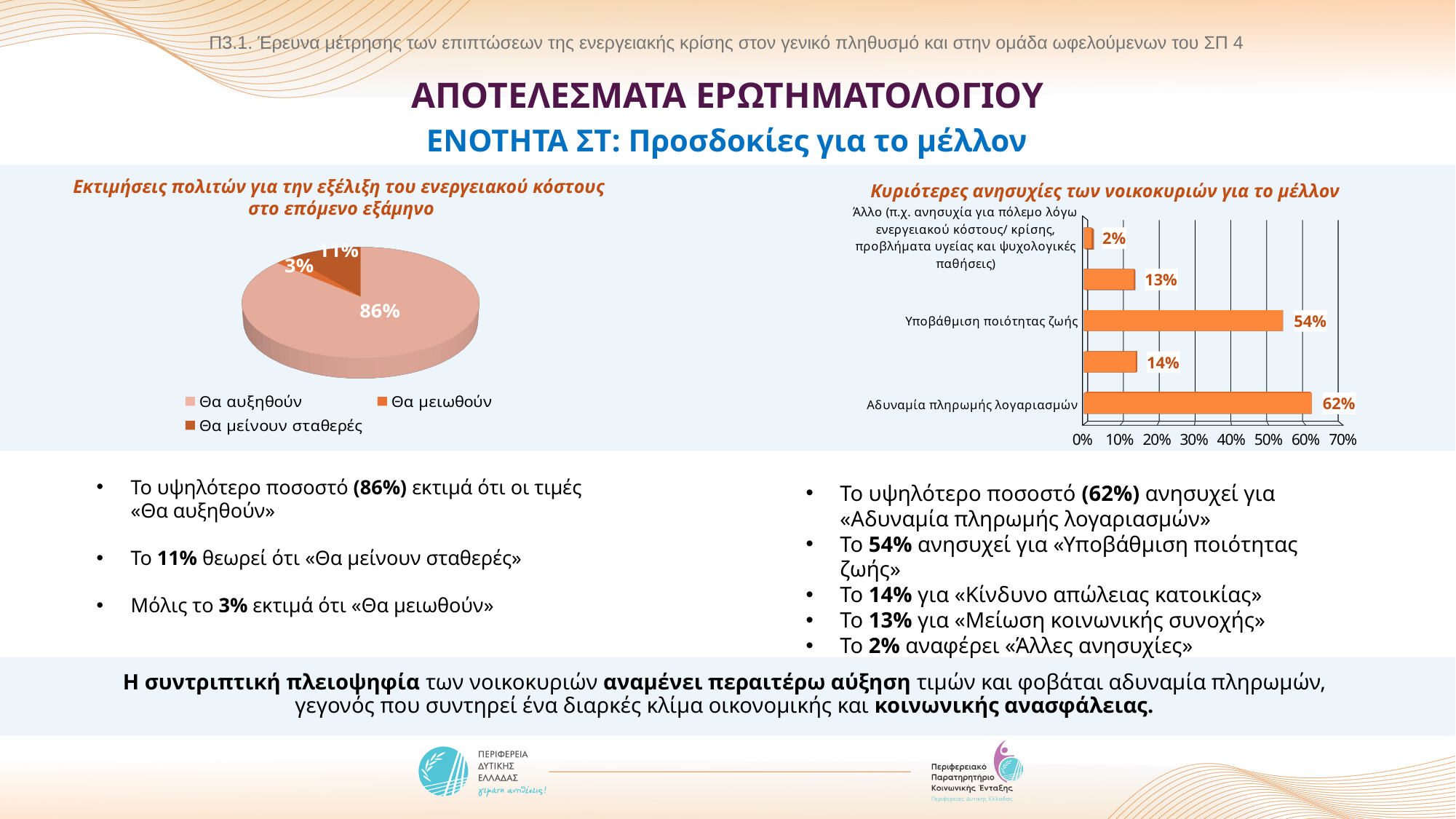
How many bars are plotted in the right bar chart? 5 In the left pie chart, what share is shown for 'Θα μείνουν σταθερές'? 11% In the right bar chart, what is the value for 'Αδυναμία πληρωμής λογαριασμών'? 62% What kind of chart is the left chart titled 'Εκτιμήσεις πολιτών για την εξέλιξη του ενεργειακού κόστους στο επόμενο εξάμηνο'? Pie chart In the right bar chart, what is the value for 'Υποβάθμιση ποιότητας ζωής'? 54% What kind of chart is the right chart titled 'Κυριότερες ανησυχίες των νοικοκυριών για το μέλλον'? Bar chart In the left pie chart, which category has the smallest slice? Θα μειωθούν In the right bar chart, which category has the highest value? Αδυναμία πληρωμής λογαριασμών How many entries does the legend of the left pie chart list? 3 In the left pie chart, what share is shown for 'Θα μειωθούν'? 3% In the left pie chart, what share is shown for 'Θα αυξηθούν'? 86% In the right bar chart, what is the difference between 'Αδυναμία πληρωμής λογαριασμών' and 'Υποβάθμιση ποιότητας ζωής'? 8%